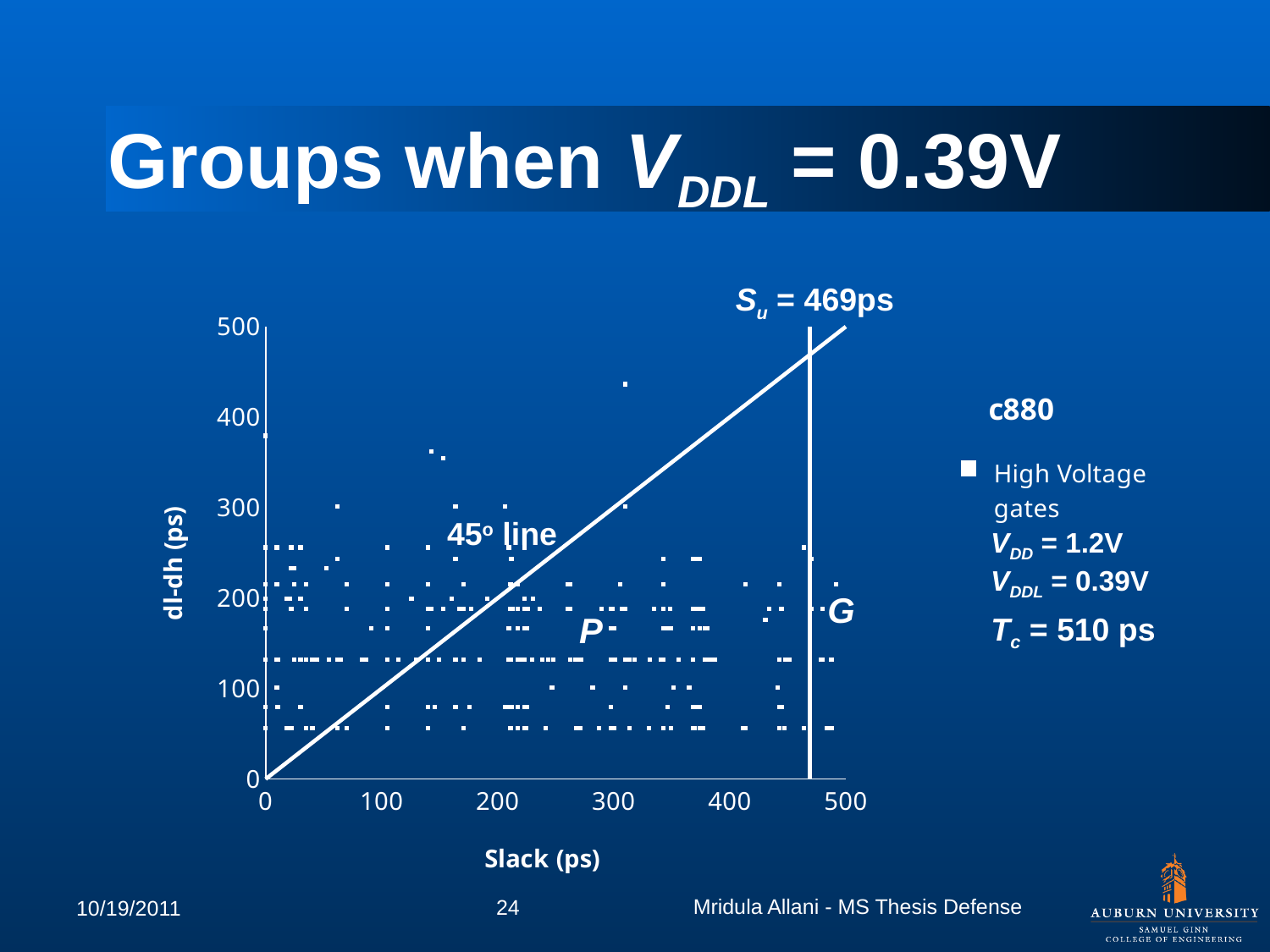
What is the label of the x axis? Slack (ps) What is the maximum value shown on the x axis? 500 What value of S_u is annotated on the chart? 469ps Is the slack value of the vertical line marked S_u greater or less than 400? greater What value of V_DDL is stated on the slide? 0.39V What value of T_c is stated on the slide? 510 ps What kind of chart is shown on the slide? scatter plot Which group label is placed to the right of the vertical S_u line? G What is the label of the y axis? dl-dh (ps) Is the dl-dh value of the highest plotted point greater or less than 400? greater Does the 45° line rise or fall as slack increases? rises